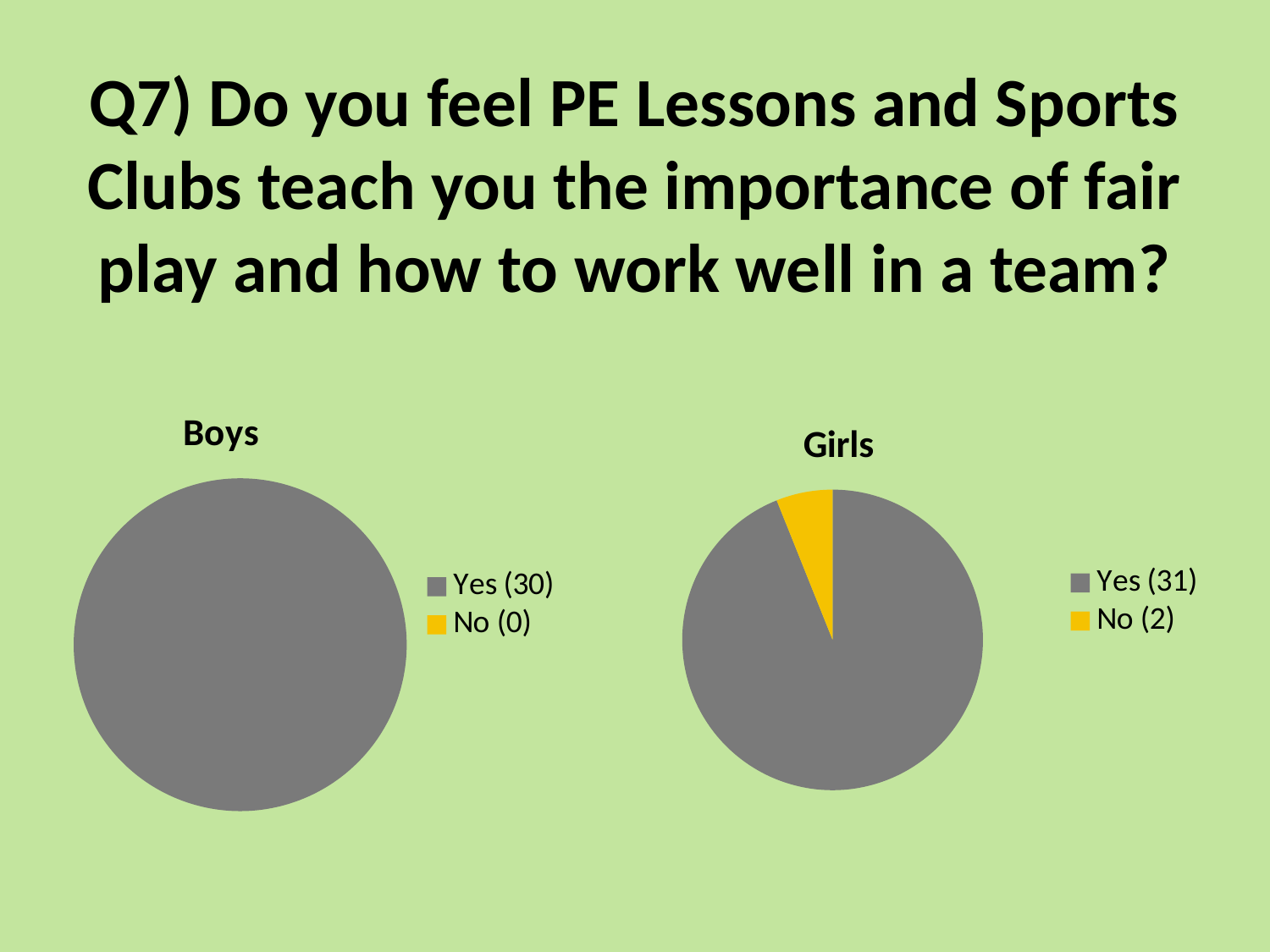
In the Girls chart, how many girls answered Yes? 31 In the Girls chart, what is the difference between the number of Yes and No responses? 29 In the Boys chart, how many boys answered No? 0 What type of chart is the Boys chart? Pie chart In the Boys chart, what colour is the Yes slice? Grey In the Boys chart, how many boys answered Yes? 30 Which is larger: the number of Yes responses in the Boys chart or in the Girls chart? Girls In the Girls chart, what is the total number of responses? 33 How many categories does the legend of the Girls chart list? 2 In the Girls chart, which response has the smallest slice? No In the Girls chart, how many girls answered No? 2 In the Girls chart, which response has the largest slice? Yes